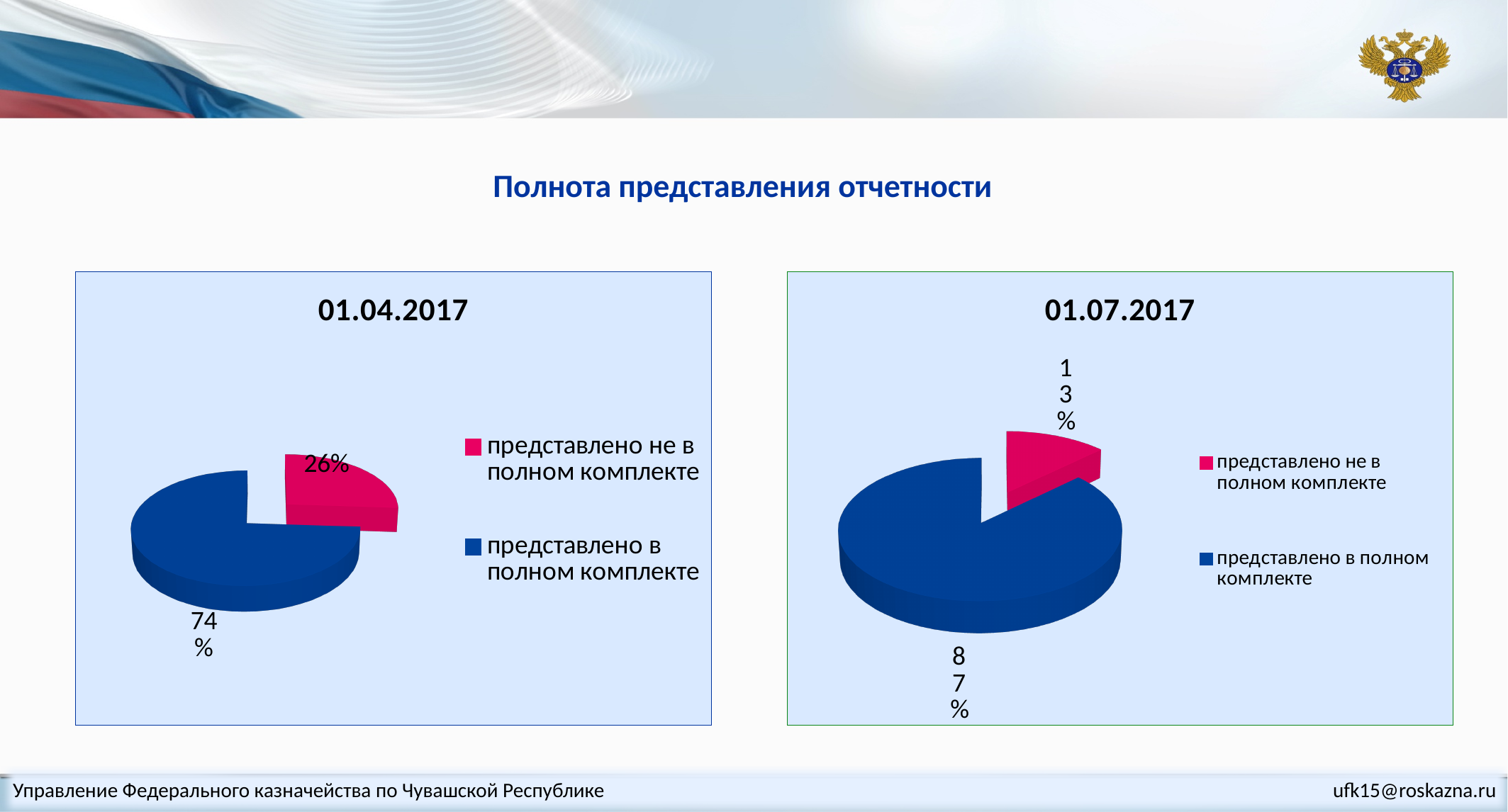
In the chart titled 01.07.2017, what share is labelled for "представлено в полном комплекте"? 87% In the chart titled 01.07.2017, what share is labelled for "представлено не в полном комплекте"? 13% In the chart titled 01.04.2017, which category has the largest slice? представлено в полном комплекте In the chart titled 01.07.2017, which category has the smallest slice? представлено не в полном комплекте In the chart titled 01.04.2017, what share is labelled for "представлено не в полном комплекте"? 26% What type of chart is shown under the title 01.07.2017? Pie chart How many entries does the legend of the chart titled 01.07.2017 list? 2 Which is larger: the "представлено не в полном комплекте" share in the 01.04.2017 chart or in the 01.07.2017 chart? 01.04.2017 In the chart titled 01.04.2017, what is the difference between the two slices' percentages? 48% How many slices does the chart titled 01.04.2017 have? 2 In the chart titled 01.04.2017, what share is labelled for "представлено в полном комплекте"? 74% In the chart titled 01.04.2017, what colour is the slice for "представлено в полном комплекте"? Blue